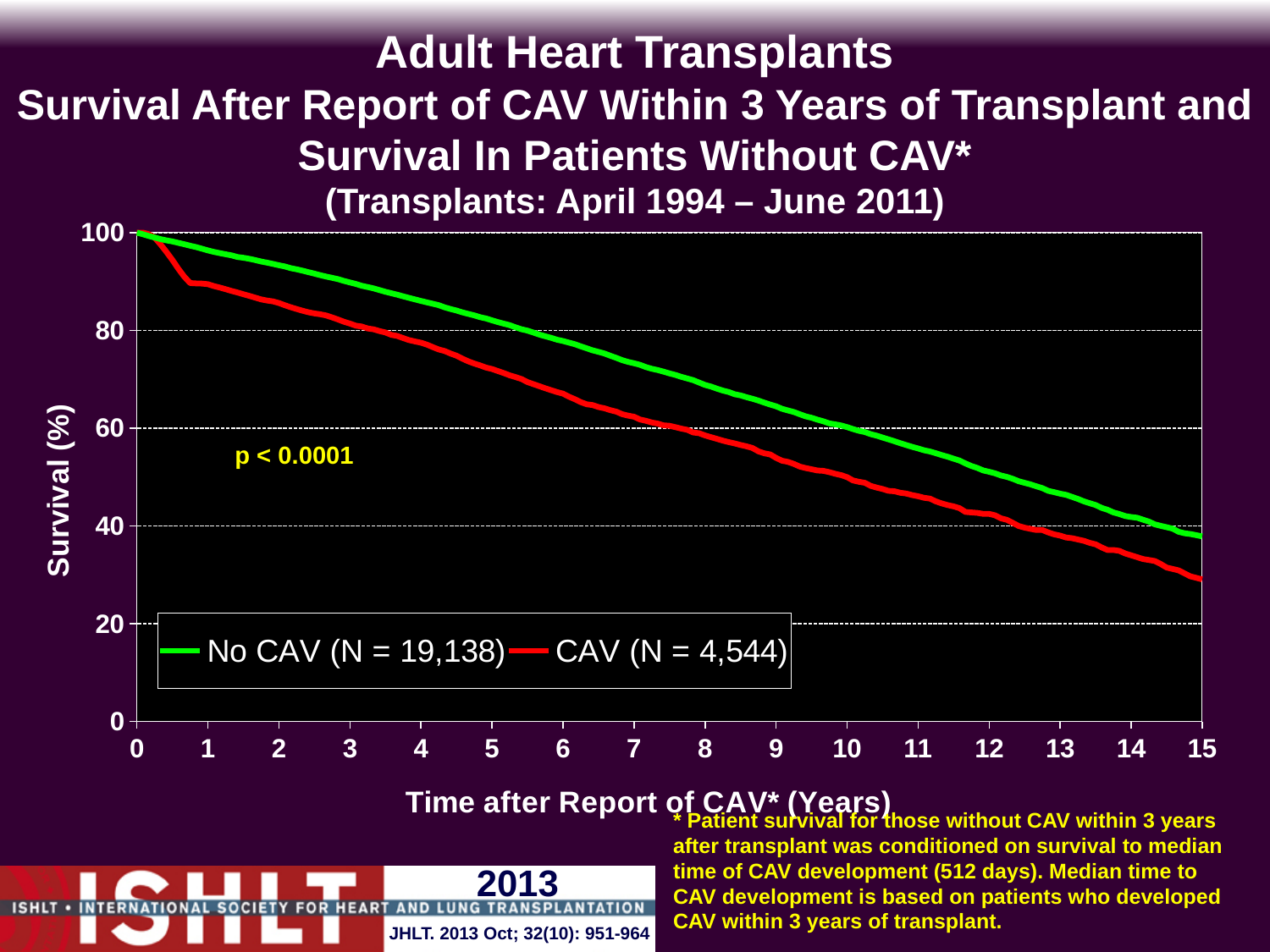
What kind of chart is shown on the slide? line chart Is the survival value for the CAV group at 5 years greater or less than 60? greater Is the survival value for the CAV group at 10 years greater or less than 60? less Do the survival values for the No CAV group rise or fall along the x axis? fall At 10 years, which group has the higher survival, No CAV or CAV? No CAV Is the survival value for the CAV group at 15 years greater or less than 40? less What is the N for the CAV group shown in the legend? 4,544 How many series does the legend list? 2 Do the survival values for the CAV group rise or fall as time after report of CAV increases? fall What is the N for the No CAV group shown in the legend? 19,138